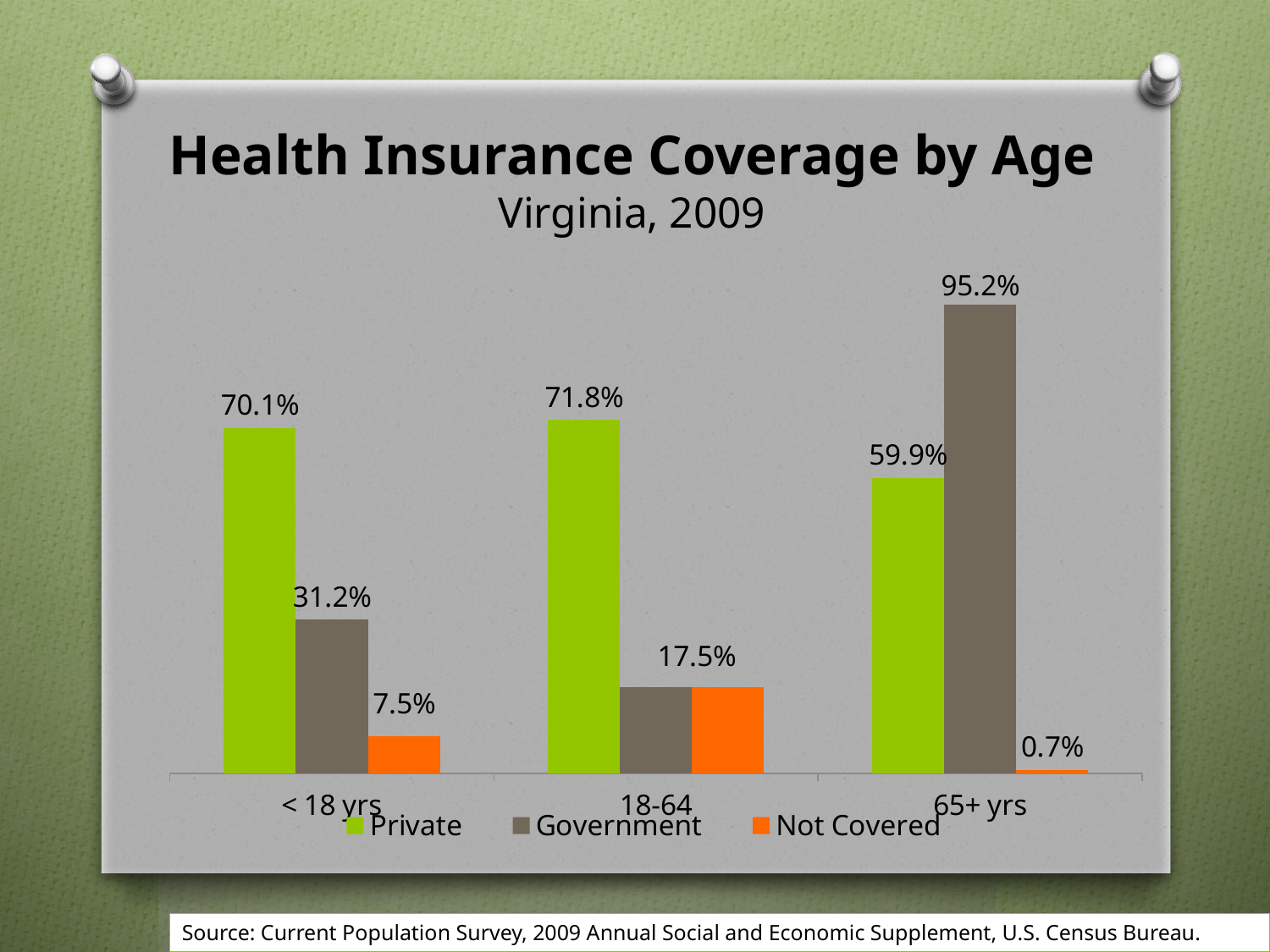
What is the difference between the Government coverage for 65+ yrs and for < 18 yrs? 64.0% What is the Government coverage value for the 65+ yrs age group? 95.2% Which age group has the highest Government coverage? 65+ yrs What is the Private coverage value for the < 18 yrs age group? 70.1% What kind of chart is shown on the slide? Bar chart How many series does the legend list? 3 Which is larger for the 65+ yrs group, Private or Government coverage? Government How many age groups are shown on the x axis? 3 What is the Private coverage value for the 18-64 age group? 71.8% Which age group has the lowest Not Covered value? 65+ yrs What is the Not Covered value for the 65+ yrs age group? 0.7% What is the Not Covered value for the < 18 yrs age group? 7.5%